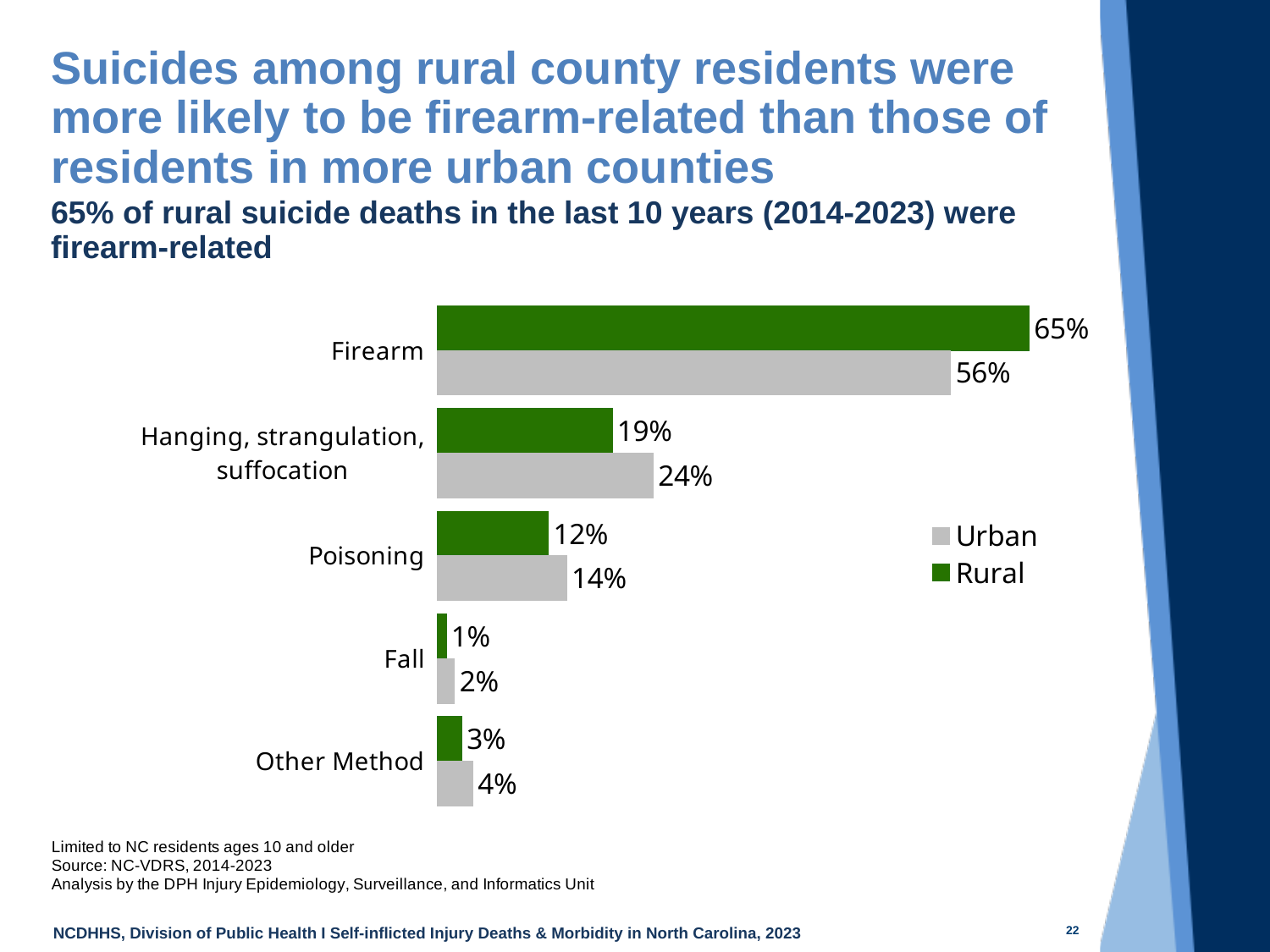
How many categories are shown on the chart? 5 What is the Urban value for Poisoning? 14% How many series does the legend list? 2 Which category has the highest Urban value? Firearm Which category has the lowest Rural value? Fall What kind of chart is shown on the slide? Bar chart What is the Urban value for Hanging, strangulation, suffocation? 24% What is the Rural value for Fall? 1% What is the Rural value for Firearm? 65% What is the difference between the Urban and Rural values for Hanging, strangulation, suffocation? 5% Which is larger for Poisoning, the Urban value or the Rural value? Urban What is the difference between the Rural and Urban values for Firearm? 9%